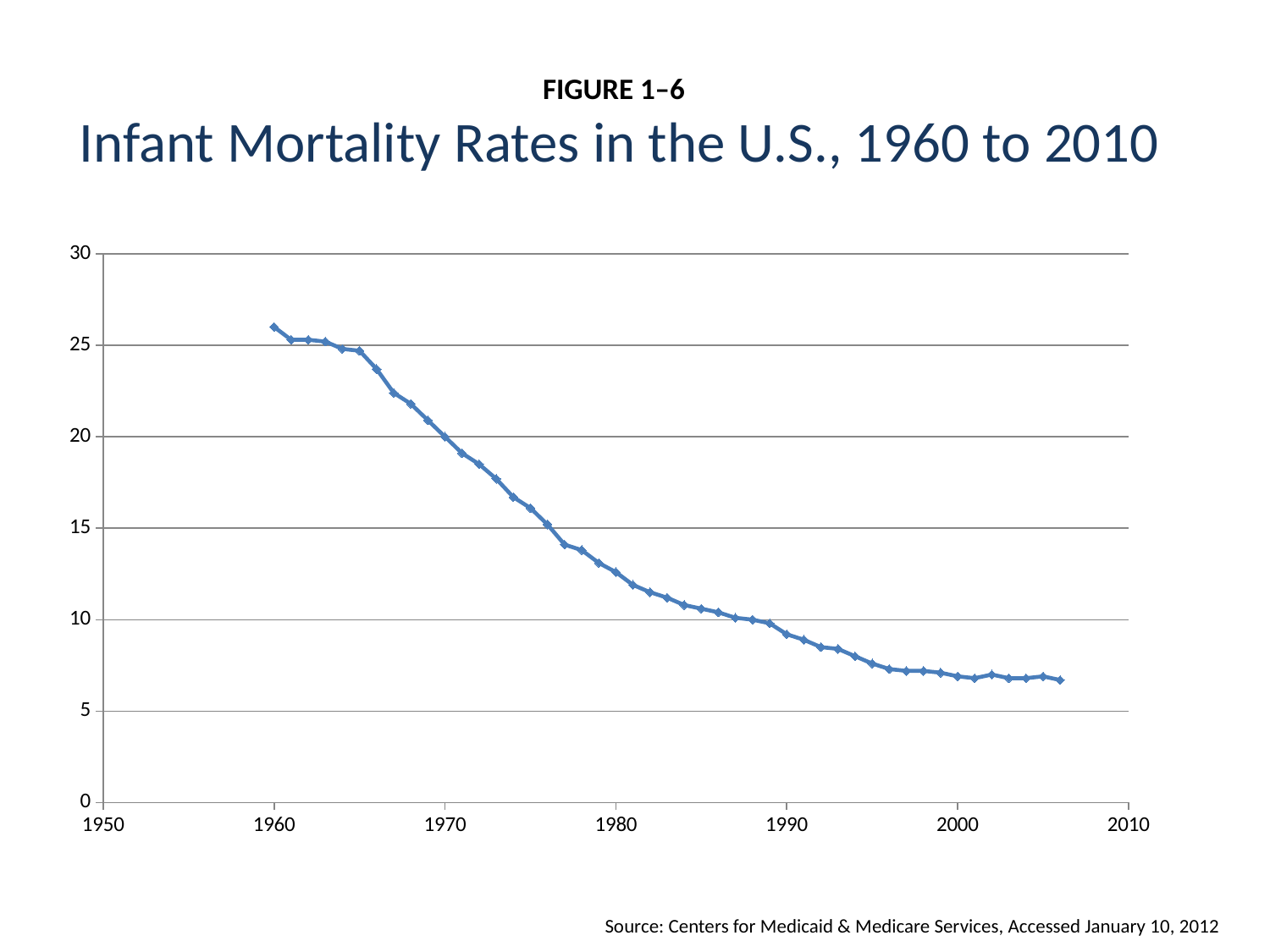
Is the infant mortality rate in 1960 greater or less than 25? greater Is the infant mortality rate in 2000 greater or less than 10? less Do the infant mortality rates rise or fall from 1960 to the end of the series? fall Which year has the higher infant mortality rate, 1980 or 1990? 1980 Is the infant mortality rate in 1980 greater or less than 15? less What kind of chart is shown on the slide? line chart In which year shown on the x axis is the infant mortality rate highest? 1960 What is the title of the chart? Infant Mortality Rates in the U.S., 1960 to 2010 What source is cited for the chart? Centers for Medicaid & Medicare Services, Accessed January 10, 2012